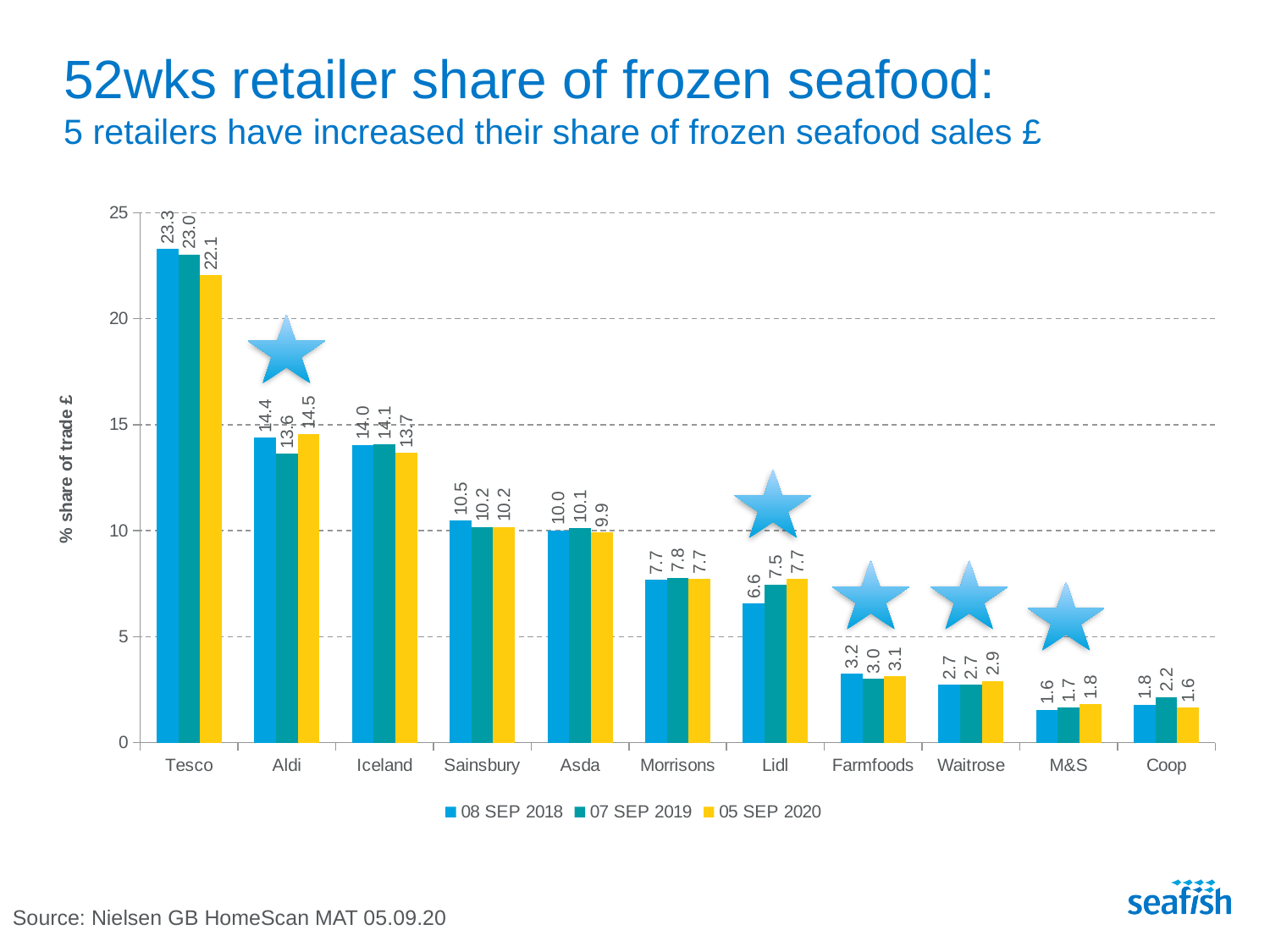
What is Aldi's share of trade for 07 SEP 2019? 13.6 What is Tesco's share of trade for 05 SEP 2020? 22.1 How many retailers are shown on the x axis? 11 What kind of chart is shown on the slide? Bar chart Which is larger for 05 SEP 2020: Aldi's share or Iceland's share? Aldi What is the label of the y axis? % share of trade £ Which retailer has the highest share of trade for 05 SEP 2020? Tesco How many series does the legend list? 3 Which retailer has the lowest share of trade for 08 SEP 2018? M&S What is the difference between Tesco's share for 08 SEP 2018 and 05 SEP 2020? 1.2 Do the 05 SEP 2020 values rise or fall from Tesco to Coop along the x axis? Fall What is Lidl's share of trade for 08 SEP 2018? 6.6